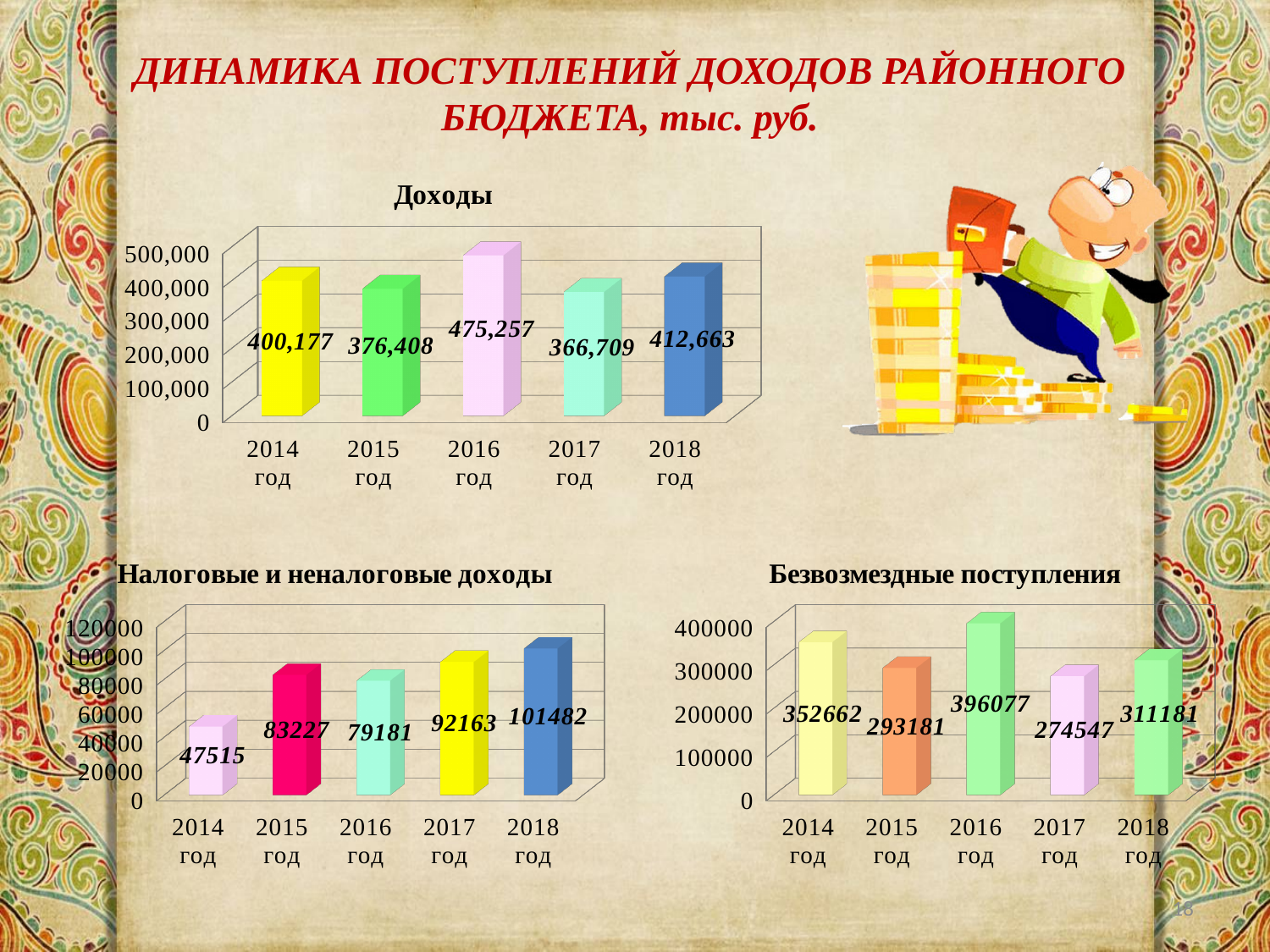
In the 'Безвозмездные поступления' chart, which year has the lowest value? 2017 год In the 'Налоговые и неналоговые доходы' chart, which year has the highest value? 2018 год In the 'Безвозмездные поступления' chart, what is the value for 2015 год? 293181 In the 'Доходы' chart, what is the value for 2016 год? 475,257 What kind of chart is the 'Безвозмездные поступления' chart? bar chart In the 'Доходы' chart, what is the difference between the values for 2016 год and 2017 год? 108,548 In the 'Налоговые и неналоговые доходы' chart, what is the value for 2014 год? 47515 In the 'Налоговые и неналоговые доходы' chart, what is the difference between the values for 2018 год and 2017 год? 9319 In the 'Доходы' chart, which year has the lowest value? 2017 год In the 'Безвозмездные поступления' chart, is the value for 2016 год greater or less than 300000? greater In the 'Налоговые и неналоговые доходы' chart, which is larger, the value for 2015 год or 2016 год? 2015 год In the 'Доходы' chart, how many bars are plotted? 5